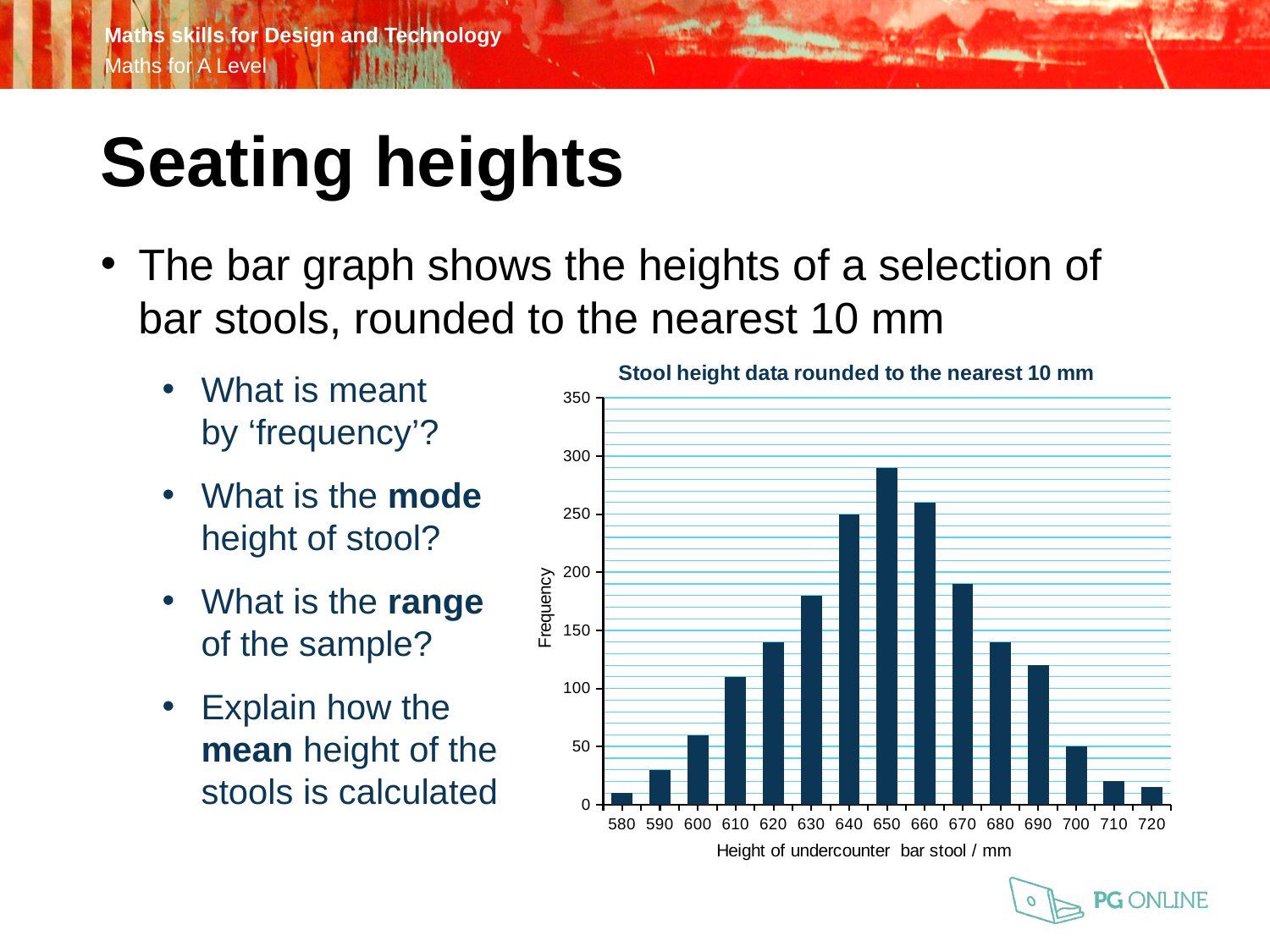
What is the frequency for the 640 mm stool height? 250 Is the frequency for 650 mm greater or less than 250? greater What type of chart is shown on the slide? bar chart What is the title of the chart? Stool height data rounded to the nearest 10 mm Is the frequency for 610 mm greater or less than 100? greater Is the frequency for 580 mm greater or less than 50? less Which stool height has the highest frequency? 650 How many height categories are shown on the x axis? 15 What is the label of the vertical axis? Frequency How do the frequencies change as stool height increases from 580 mm to 720 mm? rise to a peak at 650 then fall Which has the higher frequency, 640 mm or 670 mm? 640